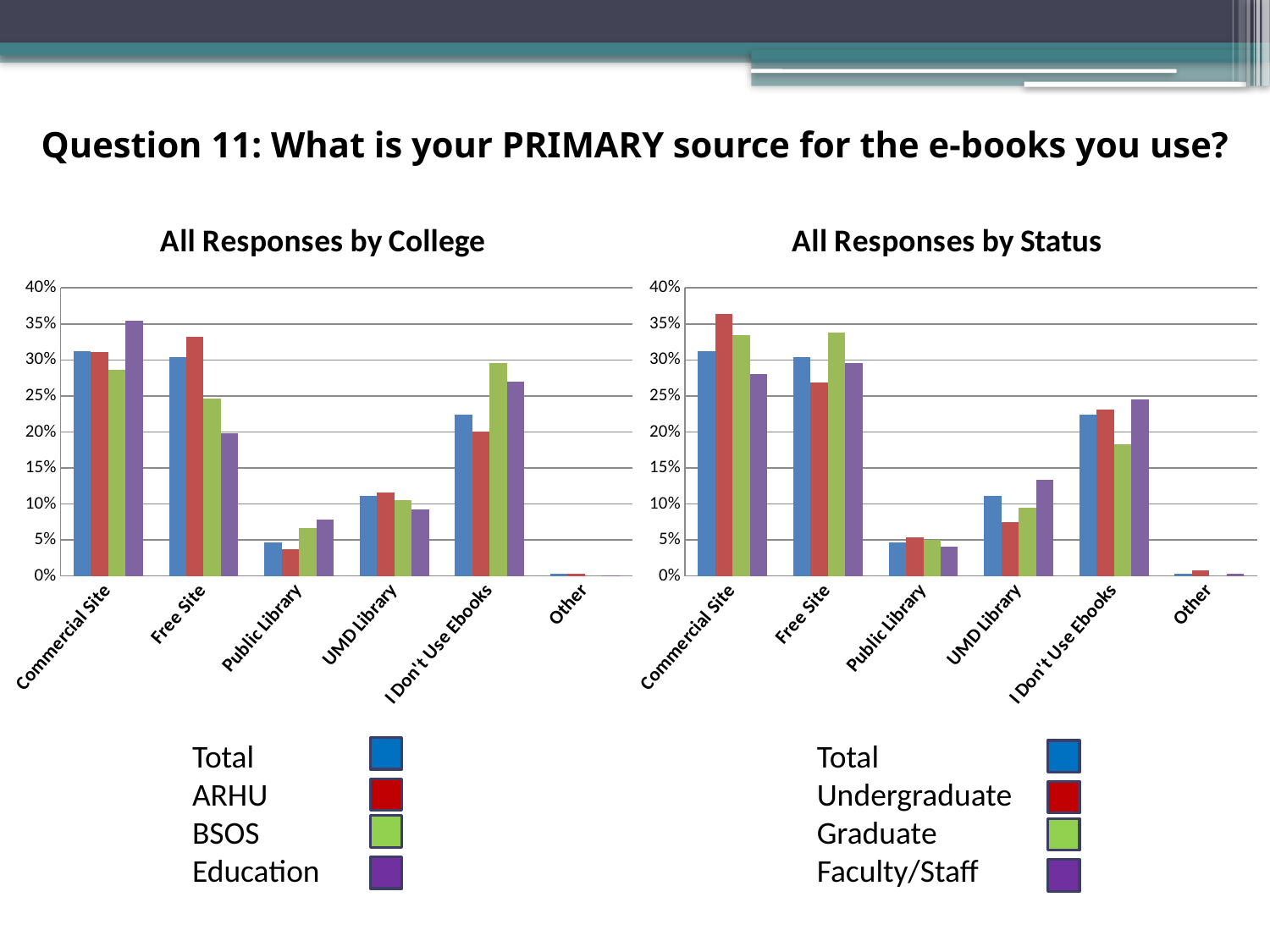
In the 'All Responses by Status' chart, is the Graduate value for Free Site greater or less than 30%? greater In the 'All Responses by College' chart, which category has the highest Education value? Commercial Site How many series does the legend of the 'All Responses by College' chart list? 4 In the 'All Responses by Status' chart, which category has the lowest Total value? Other In the 'All Responses by Status' chart, which series has the highest value for Commercial Site? Undergraduate In the 'All Responses by College' chart, is the Education value for Commercial Site greater or less than 30%? greater In the 'All Responses by College' chart, is the Total value for Public Library greater or less than 10%? less In the 'All Responses by College' chart, which is larger for Free Site: ARHU or BSOS? ARHU How many categories are shown on the x axis of the 'All Responses by Status' chart? 6 What kind of chart is the 'All Responses by College' chart? bar chart